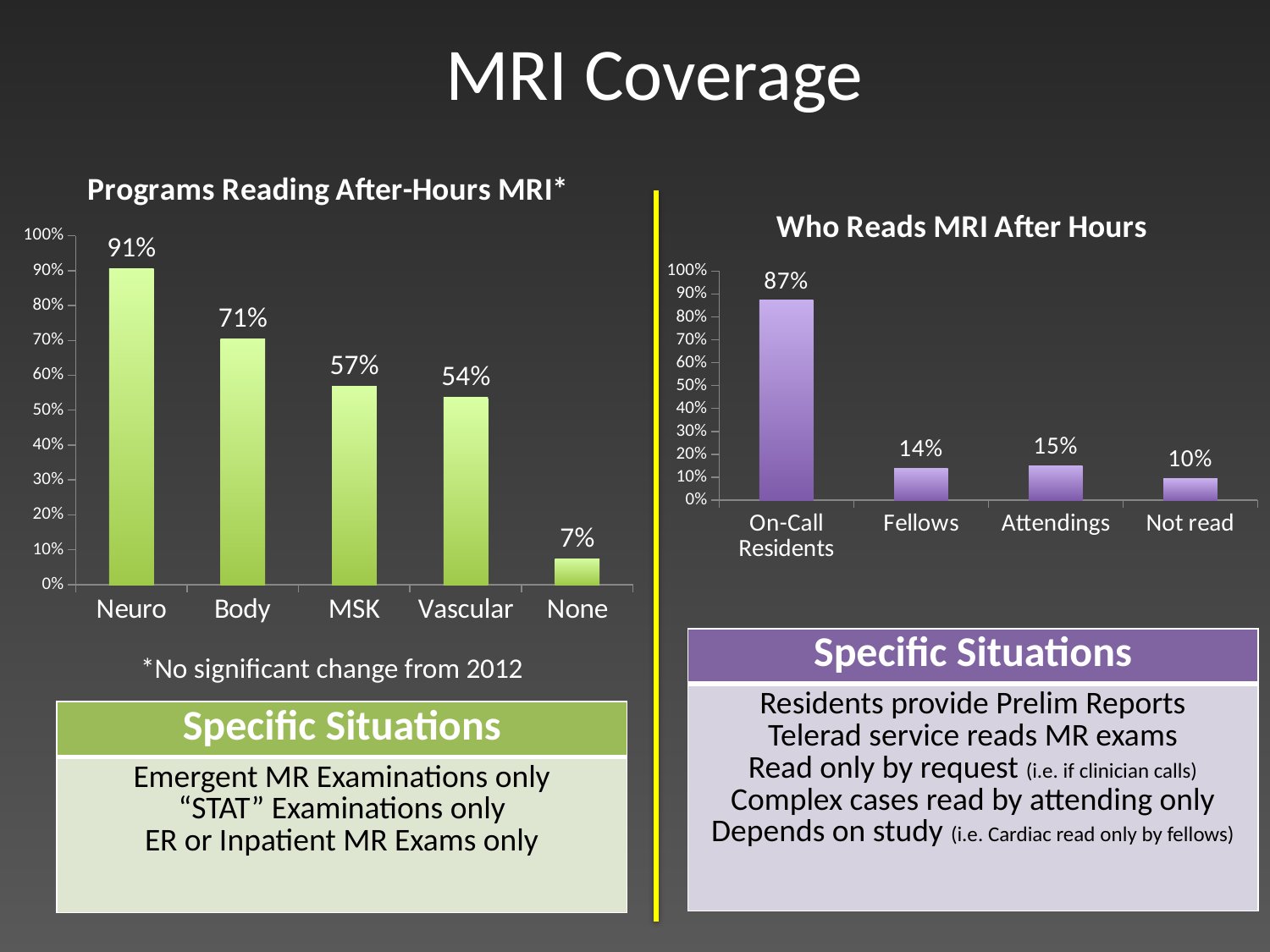
In the 'Who Reads MRI After Hours' chart, which is larger, the value for Fellows or the value for Attendings? Attendings In the 'Programs Reading After-Hours MRI*' chart, which category has the lowest value? None In the 'Who Reads MRI After Hours' chart, what is the value for On-Call Residents? 87% What kind of chart is the 'Who Reads MRI After Hours' chart? Bar chart In the 'Who Reads MRI After Hours' chart, which category has the highest value? On-Call Residents In the 'Programs Reading After-Hours MRI*' chart, what is the value for Neuro? 91% In the 'Who Reads MRI After Hours' chart, what is the difference between the values for On-Call Residents and Fellows? 73% In the 'Programs Reading After-Hours MRI*' chart, what is the difference between the values for Body and MSK? 14% In the 'Programs Reading After-Hours MRI*' chart, is the value for MSK greater or less than 50%? greater In the 'Who Reads MRI After Hours' chart, what is the value for Not read? 10% In the 'Programs Reading After-Hours MRI*' chart, how many categories are shown on the x axis? 5 In the 'Programs Reading After-Hours MRI*' chart, what is the value for Vascular? 54%